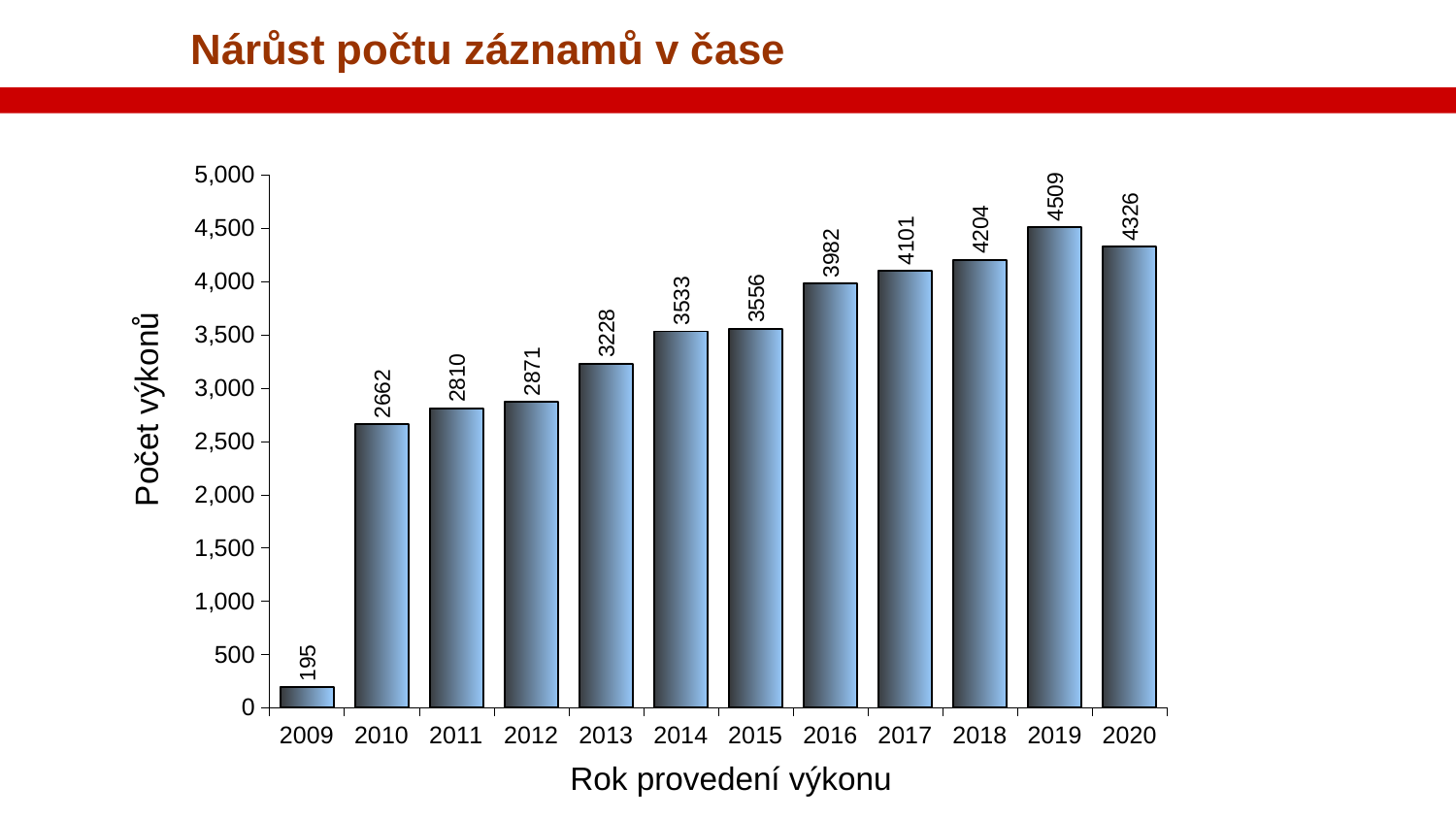
What kind of chart is this? bar chart Which year has the lowest value? 2009 What is the difference between the values for 2019 and 2020? 183 Which year has the highest value? 2019 What is the value for 2009? 195 What is the value for 2020? 4326 What is the value for 2015? 3556 What is the difference between the values for 2010 and 2009? 2467 Is the value for 2013 greater or less than 3,000? greater Which is larger, the value for 2016 or the value for 2017? 2017 What is the label of the y axis? Počet výkonů How many years are shown on the x axis? 12